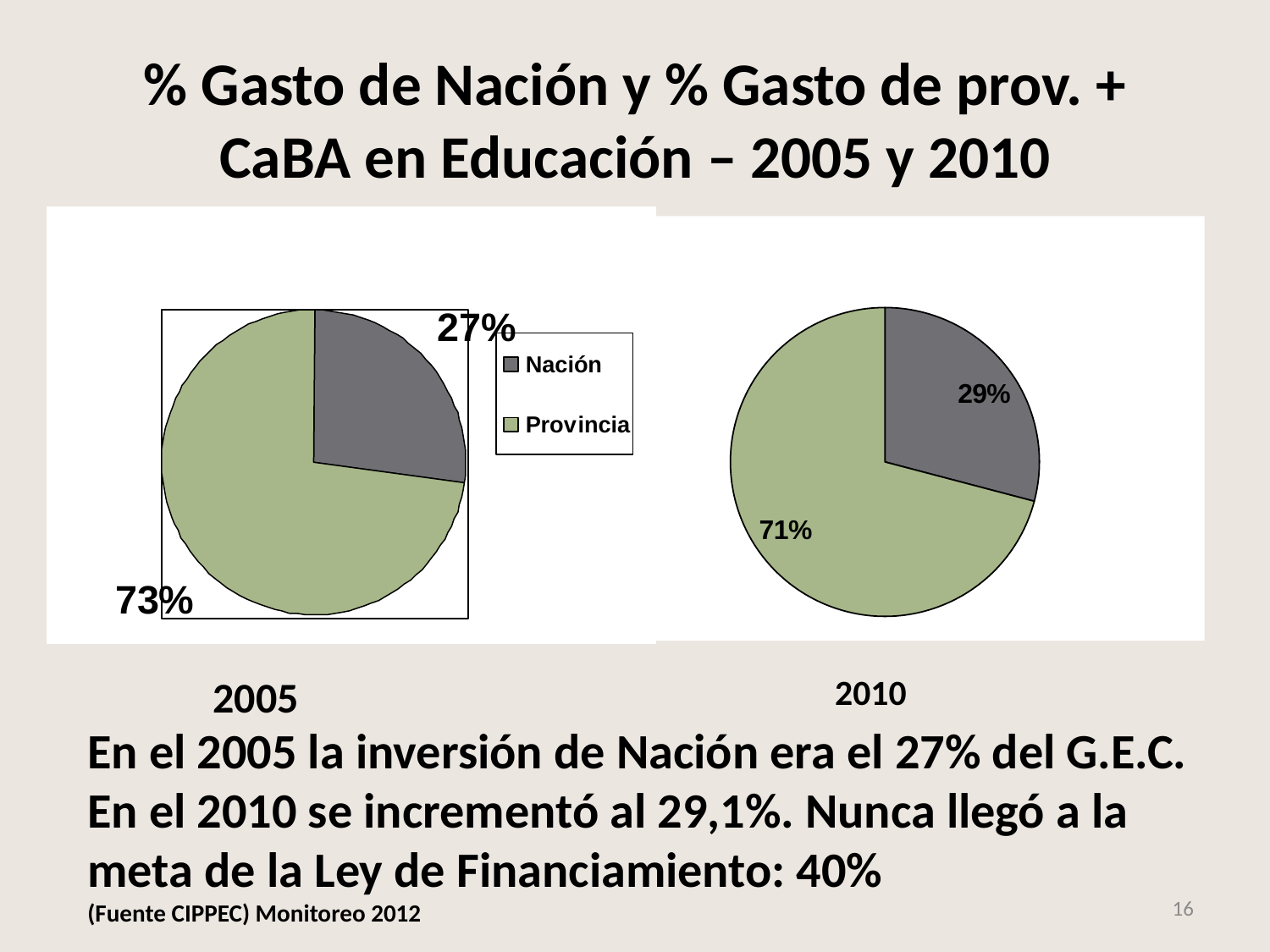
In the 2010 pie chart on the right, what is the difference between the Provincia and Nación shares? 42% Is the Nación share larger in the 2005 pie chart or in the 2010 pie chart? 2010 In the 2005 pie chart on the left, what is the difference between the Provincia and Nación shares? 46% In the 2005 pie chart on the left, which category has the largest slice? Provincia In the 2010 pie chart on the right, what share does Provincia have? 71% In the 2005 pie chart on the left, what share does Nación have? 27% In the 2005 pie chart on the left, what share does Provincia have? 73% What kind of chart is used on this slide for 2005 and 2010? Pie chart Which category is shown in green in the pie charts? Provincia How many categories does the legend list for the pie charts? 2 In the 2010 pie chart on the right, what share does Nación have? 29% In the 2010 pie chart on the right, which category has the smallest slice? Nación